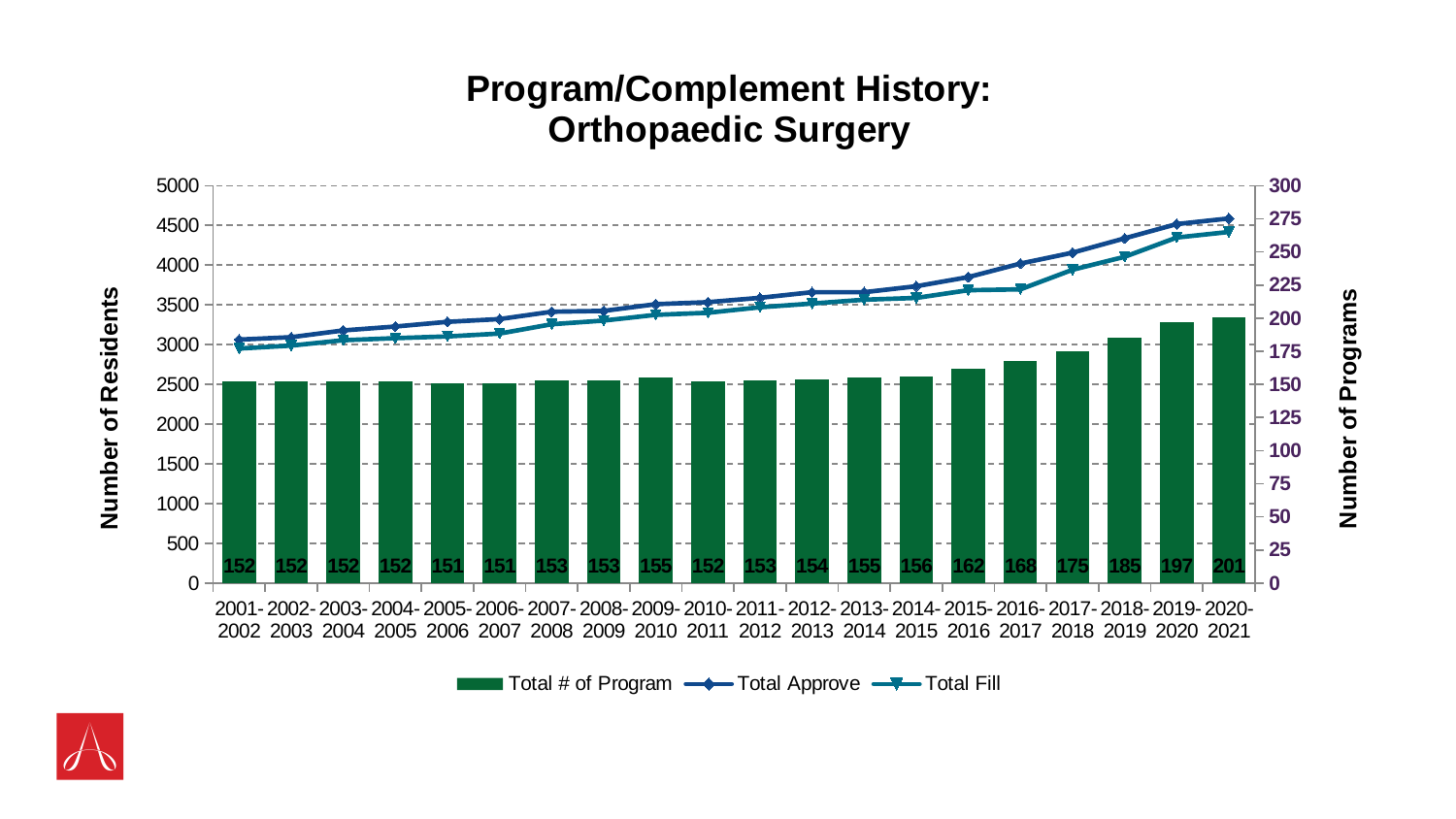
Does the Total Approve line rise or fall from 2001-2002 to 2020-2021? rise What is the lowest Total # of Program value shown on the chart? 151 What is the Total # of Program value for 2020-2021? 201 Which academic year has the highest Total # of Program? 2020-2021 Which year has a larger Total # of Program, 2017-2018 or 2018-2019? 2018-2019 How many series does the legend list? 3 Is the Total Approve value for 2015-2016 greater or less than 3500? greater Is the Total Fill value for 2019-2020 greater or less than 4000? greater What is the Total # of Program value for 2009-2010? 155 What is the Total # of Program value for 2015-2016? 162 What is the difference in Total # of Program between 2020-2021 and 2001-2002? 49 How many academic years are shown on the x axis? 20